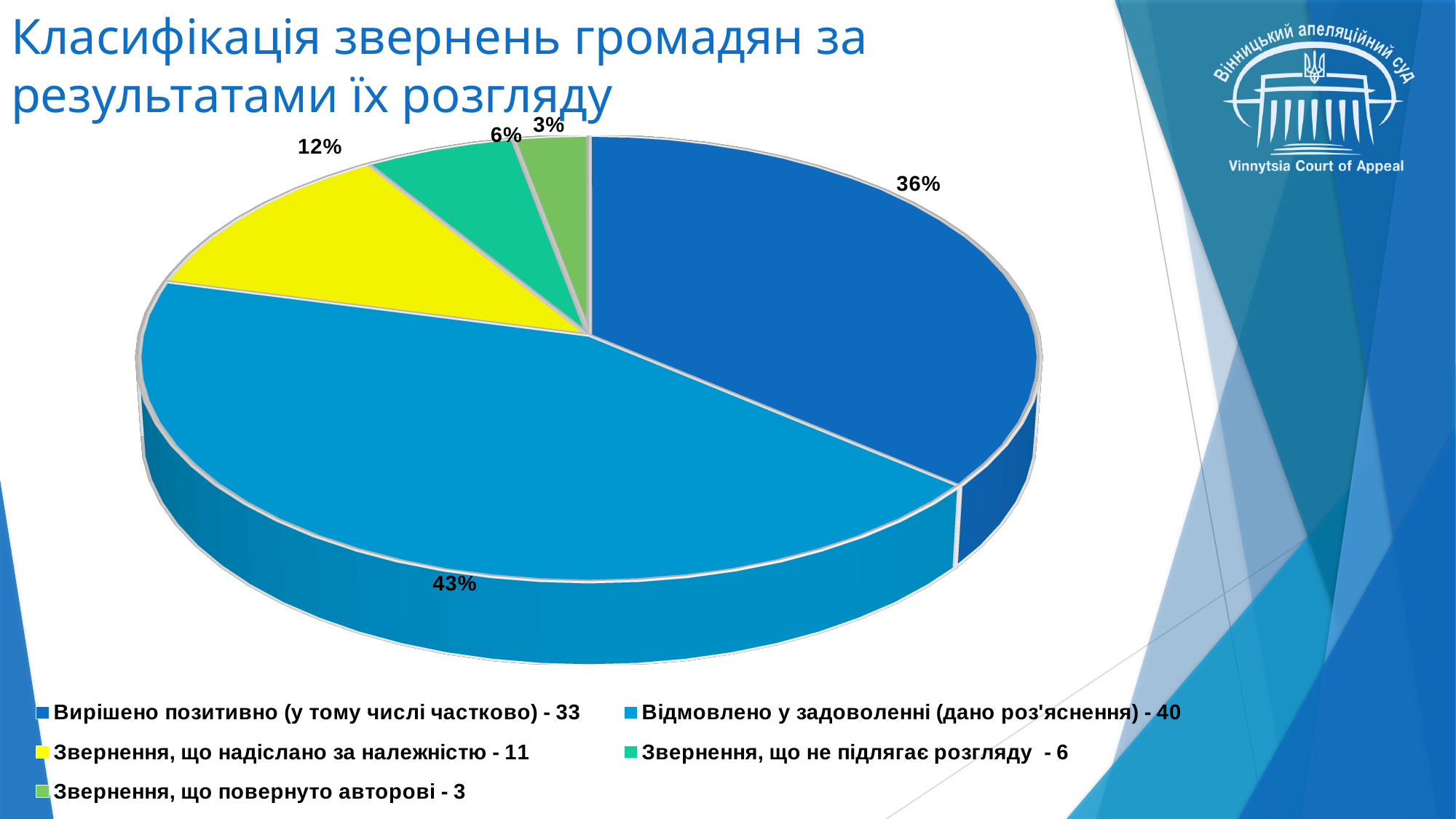
What is the title of the slide? Класифікація звернень громадян за результатами їх розгляду Which category has the smallest slice of the pie? Звернення, що повернуто авторові How many slices does the pie chart have? 5 Which slice is larger: "Звернення, що надіслано за належністю" or "Звернення, що не підлягає розгляду"? Звернення, що надіслано за належністю What share of the pie does "Відмовлено у задоволенні (дано роз'яснення)" take? 43% What share of the pie does "Звернення, що надіслано за належністю" take? 12% What kind of chart is shown on the slide? pie chart What share of the pie does "Звернення, що повернуто авторові" take? 3% What is the difference in percentage points between the 43% slice and the 36% slice? 7 Which category has the largest slice of the pie? Відмовлено у задоволенні (дано роз'яснення) According to the legend, how many appeals were in the category "Звернення, що не підлягає розгляду"? 6